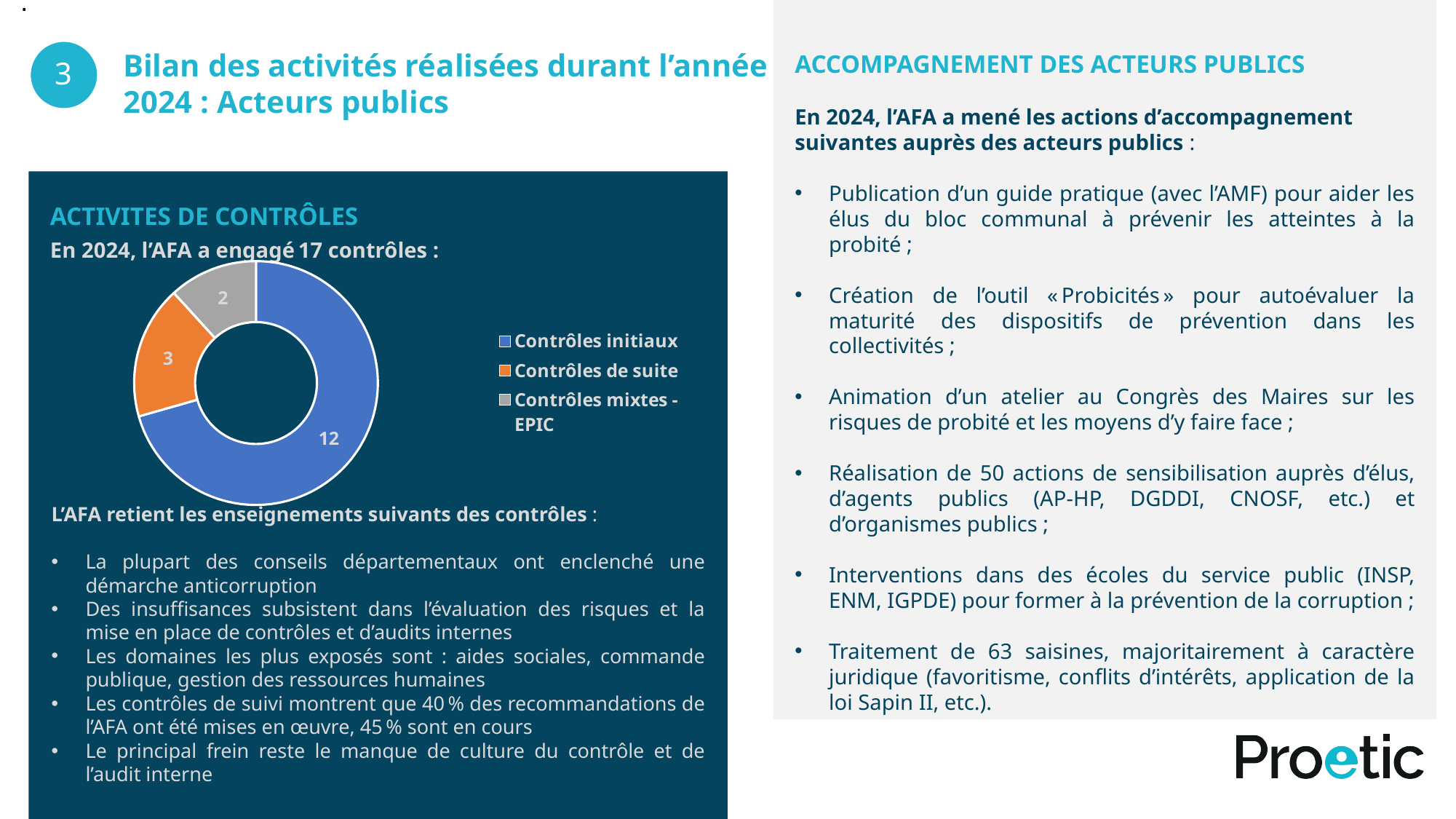
How many contrôles de suite are shown in the chart? 3 What kind of chart is shown on the slide? Doughnut chart How many contrôles initiaux are shown in the chart? 12 How many entries does the chart legend list? 3 Which is larger: Contrôles de suite or Contrôles mixtes - EPIC? Contrôles de suite What is the value for Contrôles mixtes - EPIC in the chart? 2 What colour is the Contrôles de suite slice in the chart? Orange Which category has the largest slice in the chart? Contrôles initiaux What is the difference between the number of contrôles initiaux and contrôles de suite? 9 Which category has the smallest slice in the chart? Contrôles mixtes - EPIC What is the total of all slices in the chart? 17 How many categories does the chart show? 3